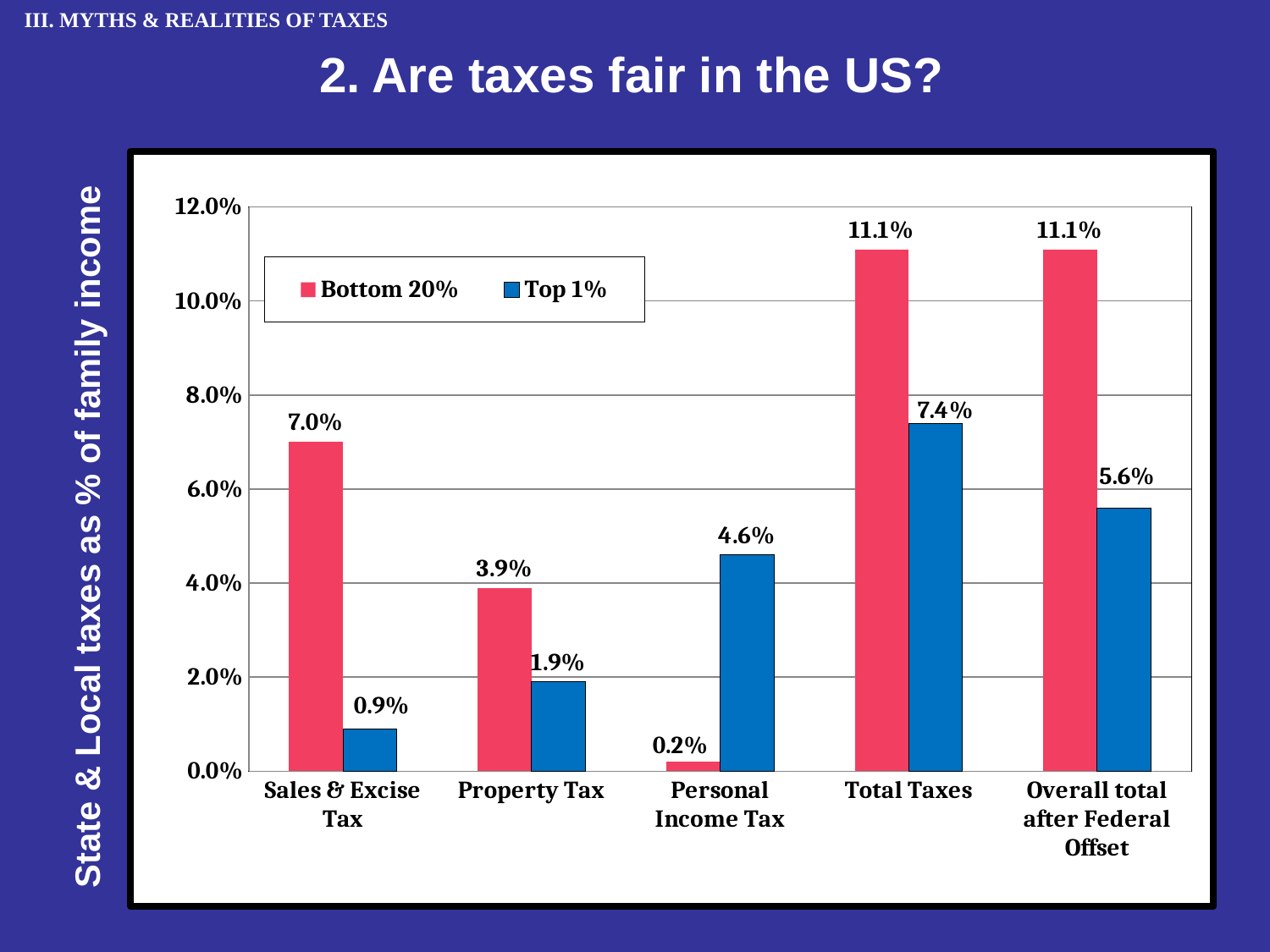
What is the value for Top 1% for Overall total after Federal Offset? 5.6% What is the difference between the Bottom 20% and Top 1% values for Total Taxes? 3.7% How many categories are shown on the x axis? 5 What is the value for Bottom 20% for Sales & Excise Tax? 7.0% For Personal Income Tax, which series has the larger value, Bottom 20% or Top 1%? Top 1% What is the difference between the Bottom 20% and Top 1% values for Sales & Excise Tax? 6.1% Which category has the highest value for the Top 1% series? Total Taxes What is the value for Top 1% for Personal Income Tax? 4.6% What is the value for Bottom 20% for Property Tax? 3.9% How many series does the legend list? 2 Which category has the lowest value for the Bottom 20% series? Personal Income Tax What kind of chart is shown on the slide? Bar chart